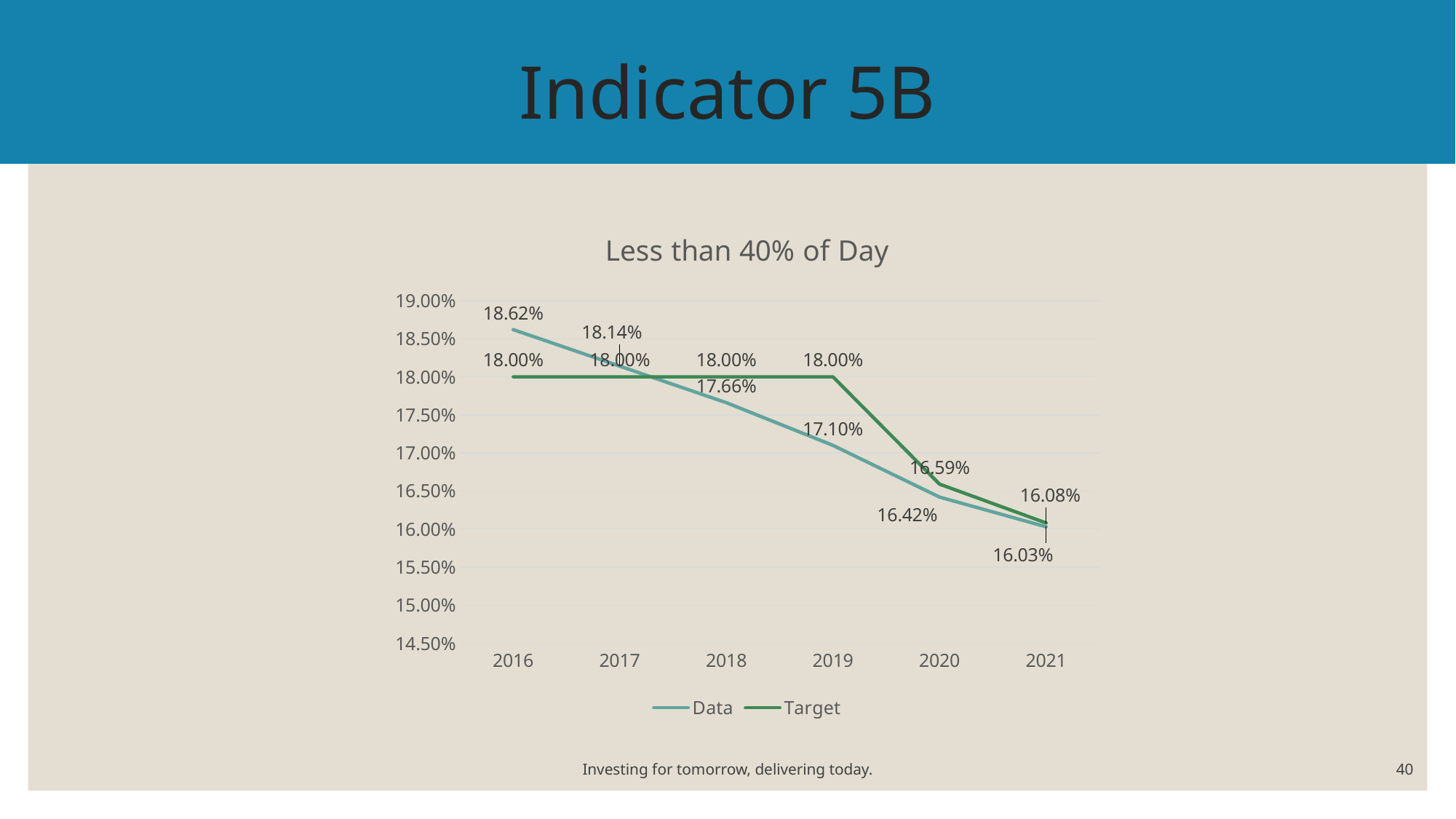
In which year is the Data series at its lowest? 2021 How many series does the legend list? 2 What is the Data value for 2016? 18.62% What is the title of the chart? Less than 40% of Day What type of chart is shown on the slide? Line chart What is the Data value for 2019? 17.10% Does the Data series rise or fall from 2016 to 2021? Fall Which is larger in 2017, the Data value or the Target value? Data What is the difference between the Data values for 2016 and 2021? 2.59% In which year is the Data series at its highest? 2016 How many years are plotted on the x axis? 6 What is the Target value for 2020? 16.59%